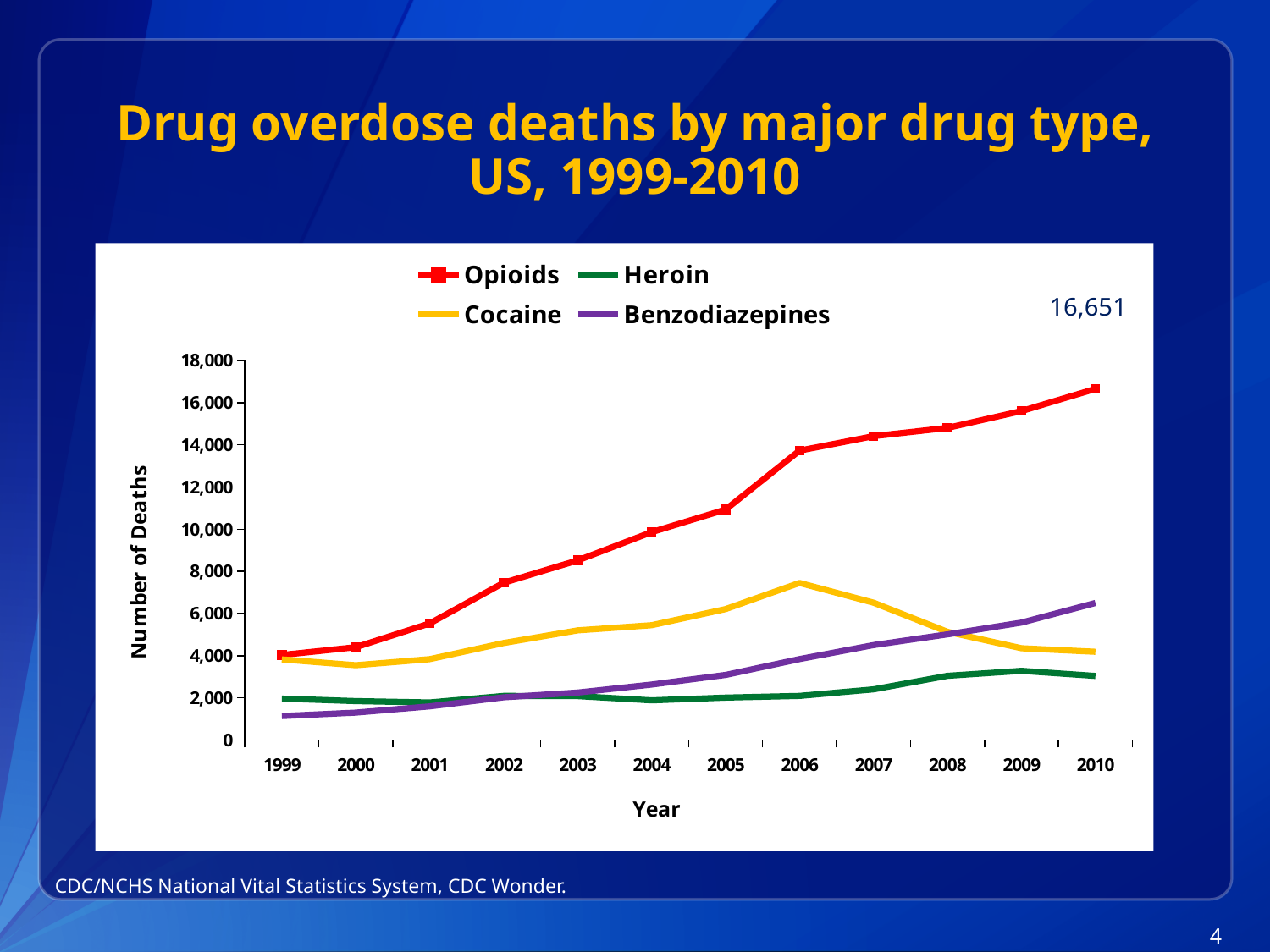
Is the value for Heroin in 2010 greater or less than 4,000? less Which drug type has the lowest number of deaths in 2010? Heroin What colour is the Opioids line? Red In 2010, which is larger: Cocaine or Benzodiazepines? Benzodiazepines What kind of chart is shown on the slide? Line chart What is the number of opioid overdose deaths in 2010, as labeled on the chart? 16,651 Is the value for Opioids in 2006 greater or less than 12,000? greater How many series does the legend list? 4 Which drug type has the highest number of deaths in 2010? Opioids In which year does the Cocaine line reach its peak? 2006 How many years are plotted along the x axis? 12 Do the Opioids values rise or fall from 1999 to 2010? Rise